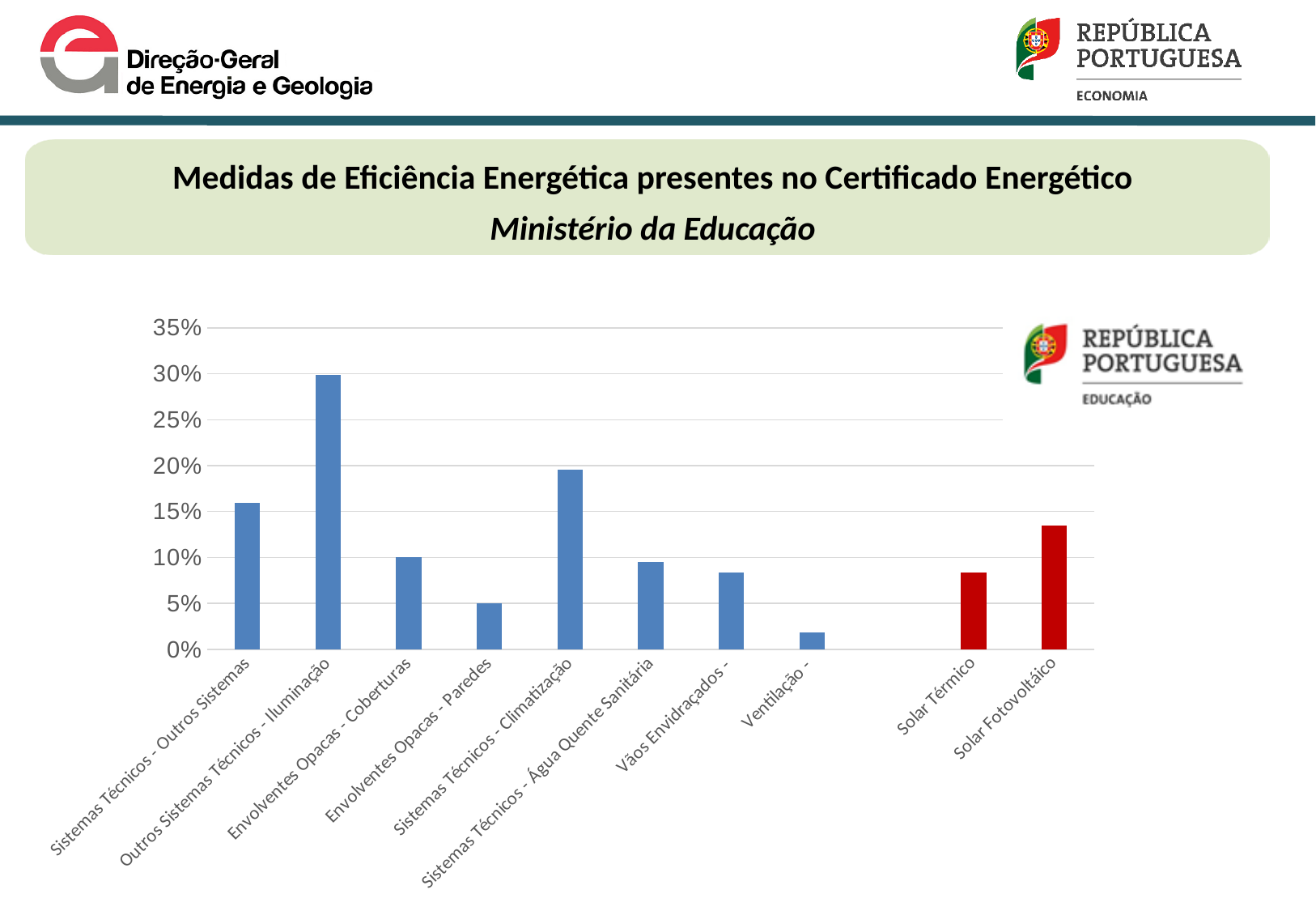
Is the value for Envolventes Opacas - Paredes greater or less than 10%? less Which is larger, the value for Sistemas Técnicos - Climatização or for Envolventes Opacas - Coberturas? Sistemas Técnicos - Climatização Which is larger, the value for Solar Fotovoltáico or for Solar Térmico? Solar Fotovoltáico What kind of chart is shown on the slide? Bar chart Is the value for Ventilação greater or less than 5%? less Which category has the highest value? Outros Sistemas Técnicos - Iluminação What colour are the bars for Solar Térmico and Solar Fotovoltáico? Red Which category has the lowest value? Ventilação Is the value for Outros Sistemas Técnicos - Iluminação greater or less than 25%? greater How many categories are plotted on the chart? 10